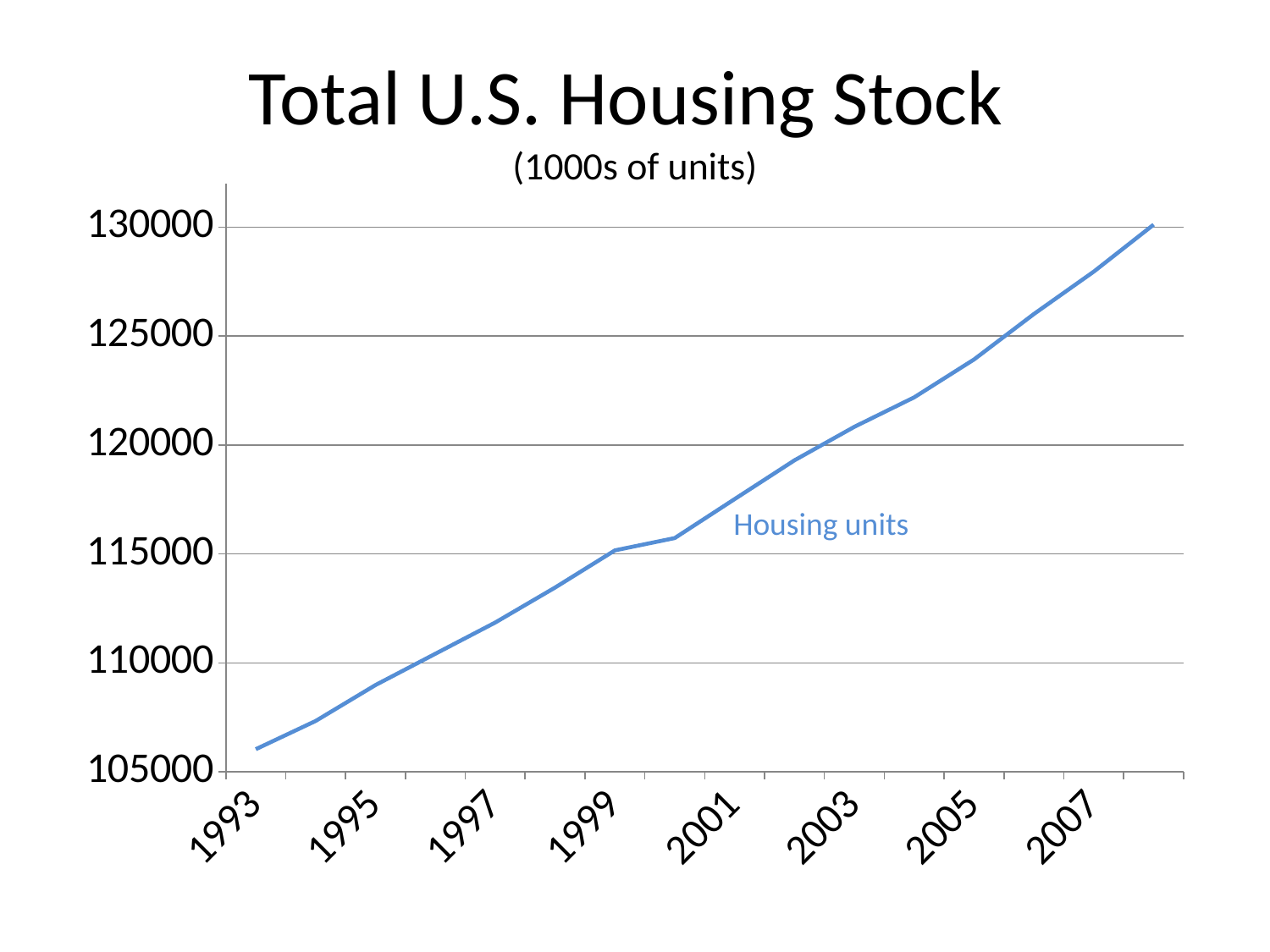
Is the value for housing units in 2001 greater or less than 120000? less Which labeled year has the highest value for housing units? 2007 What is the name of the series plotted on the chart? Housing units How many series are plotted on the chart? 1 Is the value for housing units in 2003 greater or less than 120000? greater What is the title of the chart? Total U.S. Housing Stock Which year has the larger value for housing units, 1997 or 2003? 2003 Which labeled year has the lowest value for housing units? 1993 What kind of chart is shown on the slide? line chart Do the housing units values rise or fall from 1993 to 2007? rise Is the value for housing units in 1993 greater or less than 110000? less